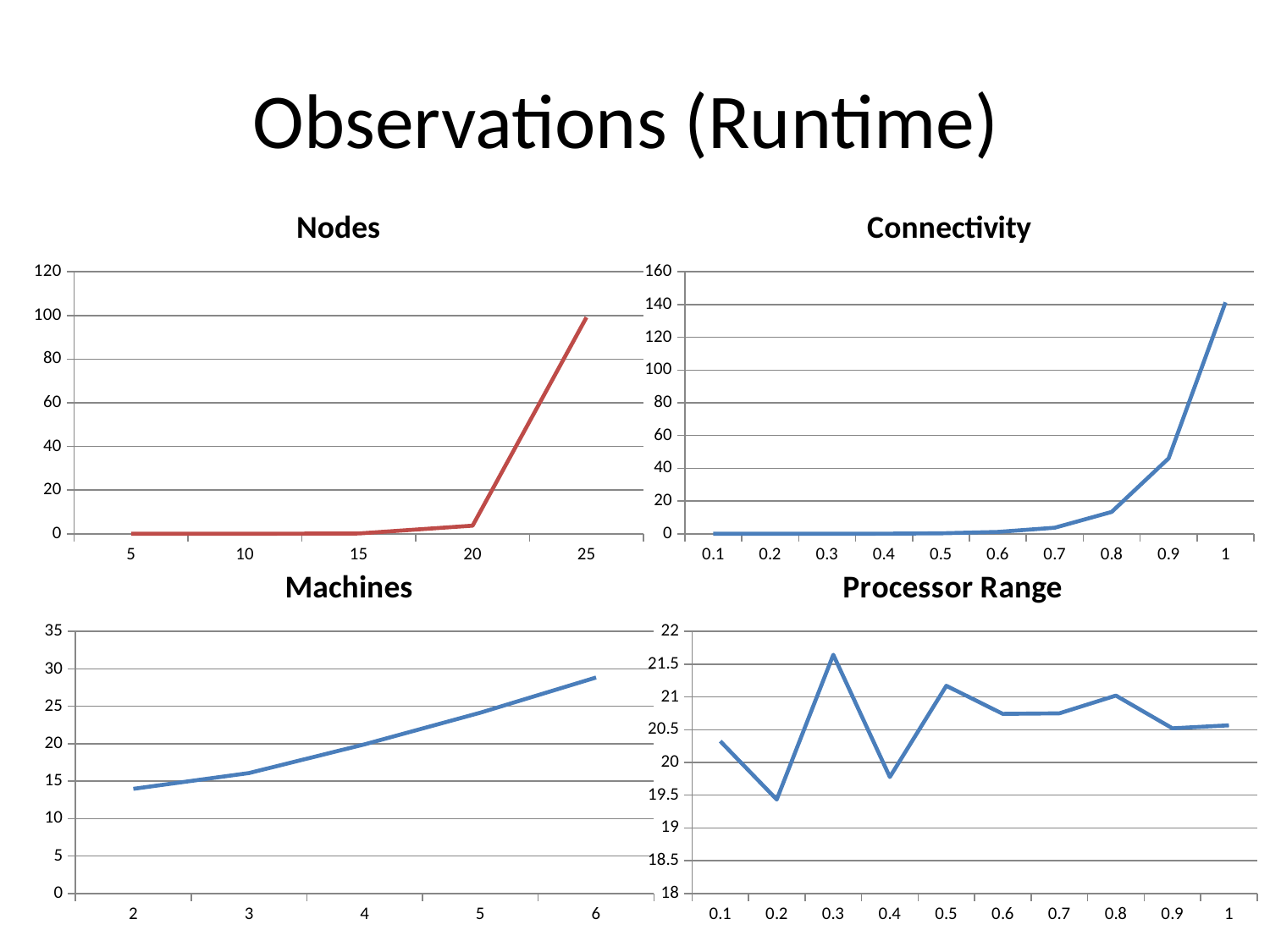
In the Nodes chart, is the value at 25 greater or less than 80? greater In the Machines chart, is the value at 6 greater or less than 25? greater In the Processor Range chart, which is larger, the value at 0.3 or the value at 0.4? 0.3 In the Nodes chart, at which x value is the runtime highest? 25 In the Processor Range chart, at which x value is the runtime highest? 0.3 In the Machines chart, do the values rise or fall as the number of machines increases from 2 to 6? rise In the Processor Range chart, at which x value is the runtime lowest? 0.2 In the Connectivity chart, is the value at 1 greater or less than 120? greater What kind of chart is the Nodes chart? line chart In the Connectivity chart, at which x value is the runtime highest? 1 In the Nodes chart, how many data points are plotted? 5